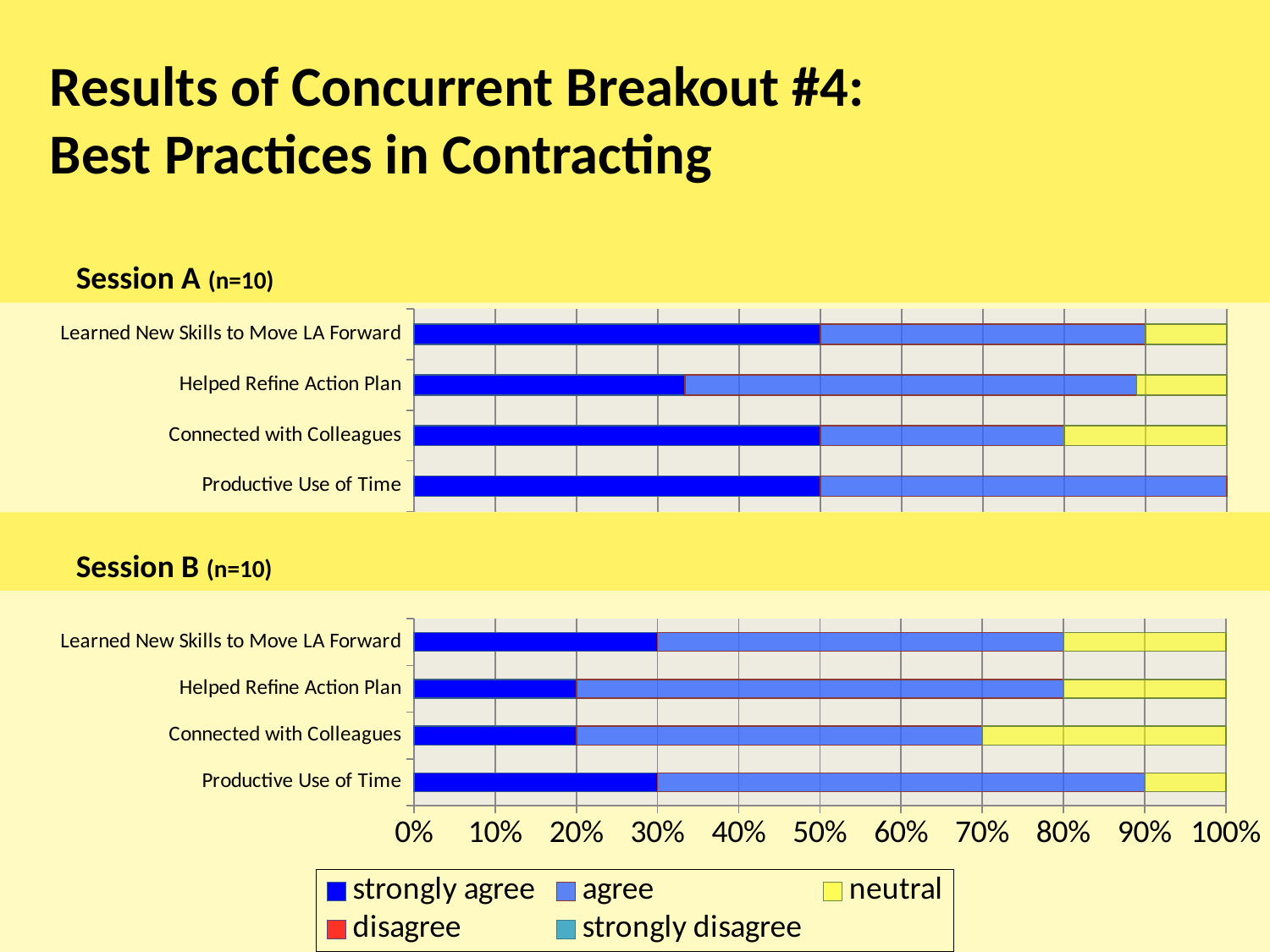
In the Session B chart, is the 'neutral' value for Connected with Colleagues greater or less than 20%? greater How many categories are shown in the Session B chart? 4 In the Session A chart, what is the 'strongly agree' value for Productive Use of Time? 50% In the Session A chart, which category has the lowest 'strongly agree' value? Helped Refine Action Plan What is the sample size (n) shown for Session A? n=10 How many series does the legend list? 5 What kind of chart is used for Session A? bar chart In the Session B chart, what is the 'strongly agree' value for Learned New Skills to Move LA Forward? 30% In the Session A chart, is the 'strongly agree' value for Helped Refine Action Plan greater or less than 40%? less In the Session B chart, what is the 'strongly agree' value for Helped Refine Action Plan? 20% In the Session B chart, which category has the largest 'neutral' segment? Connected with Colleagues Is the 'strongly agree' value for Productive Use of Time larger in the Session A chart or the Session B chart? Session A